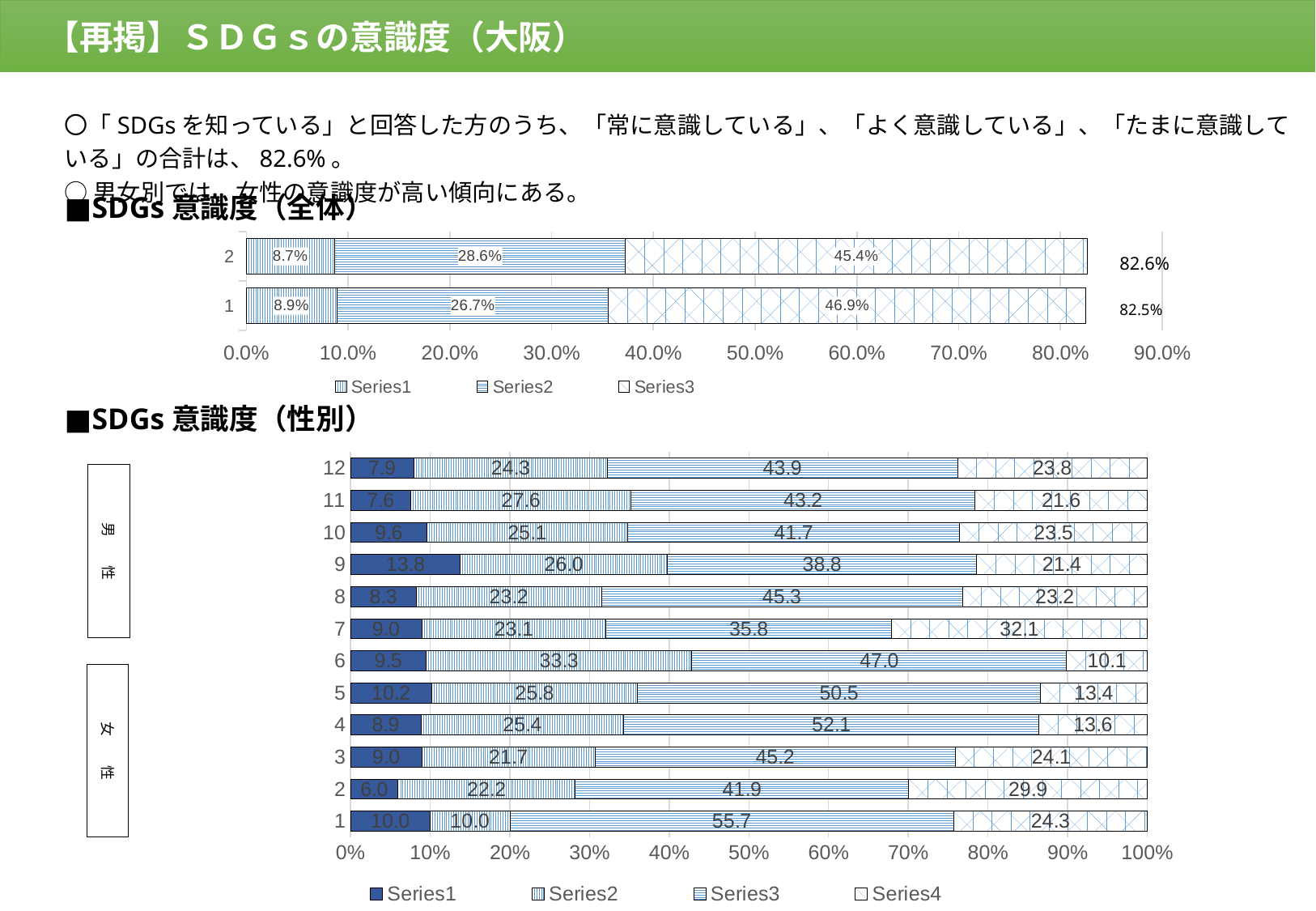
In the SDGs 意識度（性別） chart, what is the difference between the Series4 values for category 2 and category 1? 5.6 In the SDGs 意識度（全体） chart, what is the Series3 value for category 1? 46.9% In the SDGs 意識度（性別） chart, what is the Series3 value for category 1? 55.7 In the SDGs 意識度（全体） chart, what is the Series2 value for category 2? 28.6% In the SDGs 意識度（性別） chart, which is larger, the Series3 value for category 4 or for category 12? category 4 In the SDGs 意識度（性別） chart, which category has the highest Series1 value? 9 In the SDGs 意識度（性別） chart, which category has the lowest Series4 value? 6 In the SDGs 意識度（性別） chart, how many categories are plotted? 12 In the SDGs 意識度（全体） chart, what is the difference between the Series1 values for category 1 and category 2? 0.2% In the SDGs 意識度（全体） chart, how many series does the legend list? 3 What kind of chart is the SDGs 意識度（性別） chart? stacked bar chart In the SDGs 意識度（全体） chart, what total is shown to the right of the bar for category 2? 82.6%